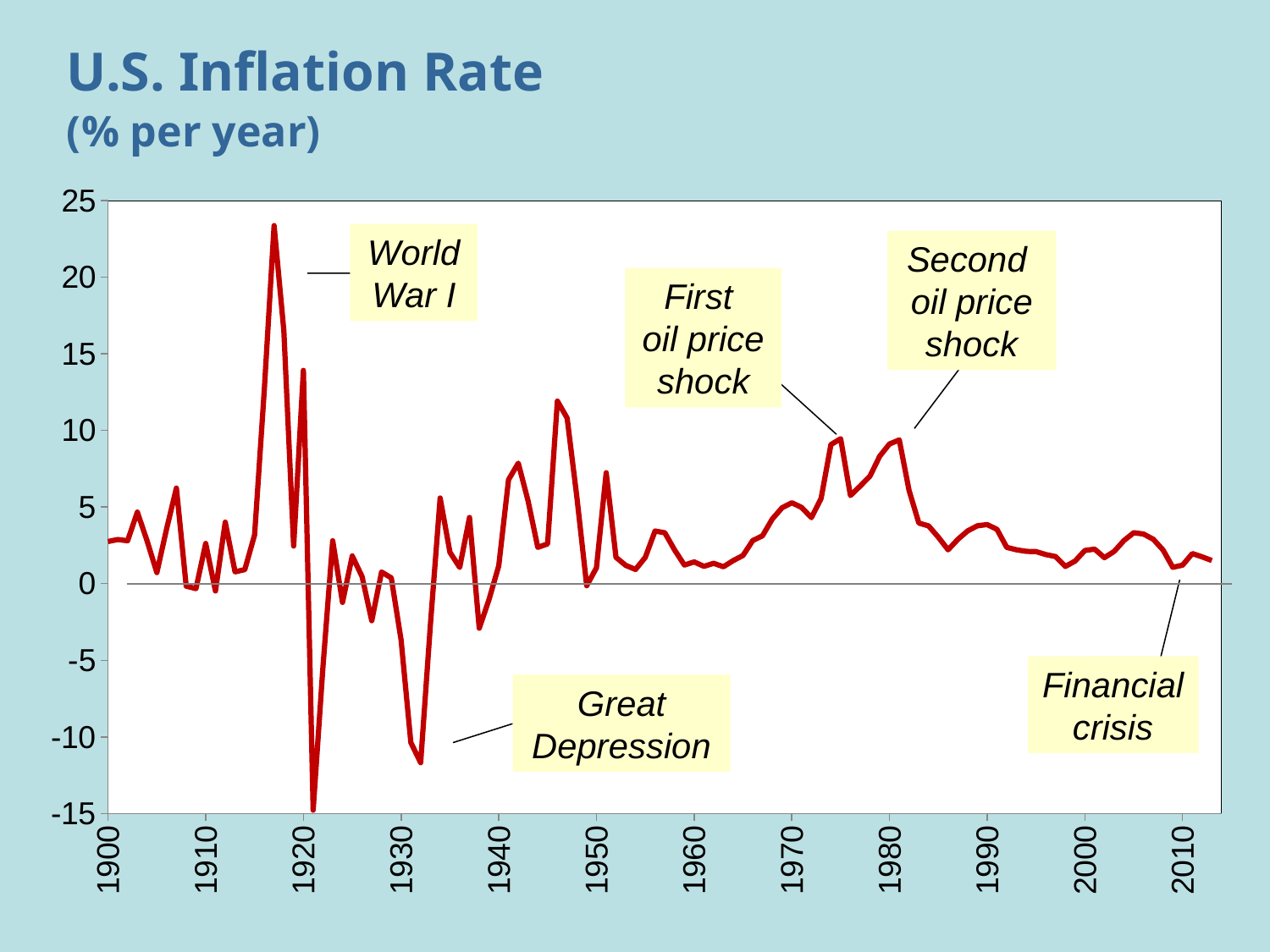
Is the inflation rate at the Great Depression trough greater or less than -10? less How many annotated events are labelled on the chart? 5 Which annotated event corresponds to the highest inflation rate on the chart? World War I Between 1980 and 1990, does the inflation rate generally rise or fall? fall Is the inflation rate at the World War I peak greater or less than 20? greater What is the title of the chart? U.S. Inflation Rate (% per year) Is the inflation rate at the Second oil price shock peak greater or less than 10? less Which is higher, the inflation rate at the World War I peak or at the First oil price shock peak? World War I peak In which decade does the lowest inflation rate on the chart occur? 1920s What kind of chart is shown on the slide? line chart